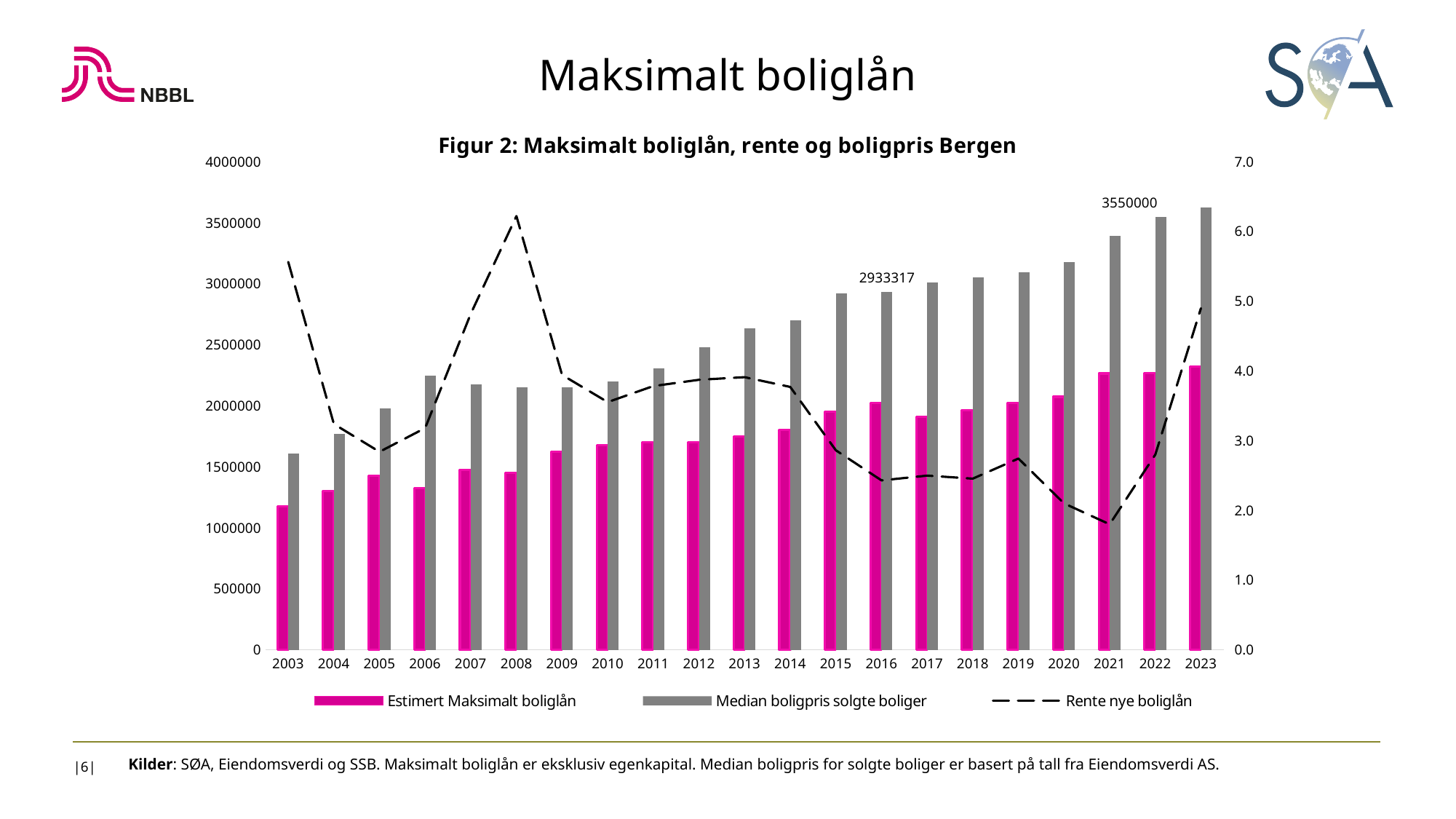
In which year is Estimert Maksimalt boliglån lowest? 2003 How many series does the legend list? 3 What is the value of Median boligpris solgte boliger in 2016? 2933317 What is the difference between the Median boligpris solgte boliger values in 2022 and 2016? 616683 What is the value of Median boligpris solgte boliger in 2022? 3550000 Is the value for Rente nye boliglån in 2021 greater or less than 3.0? less In 2016, which is larger: Estimert Maksimalt boliglån or Median boligpris solgte boliger? Median boligpris solgte boliger Does Median boligpris solgte boliger rise or fall from 2015 to 2023? rise Is the value for Estimert Maksimalt boliglån in 2023 greater or less than 2000000? greater Is the value for Rente nye boliglån in 2008 greater or less than 5.0? greater How many years are shown on the x axis? 21 In which year is Median boligpris solgte boliger highest? 2023